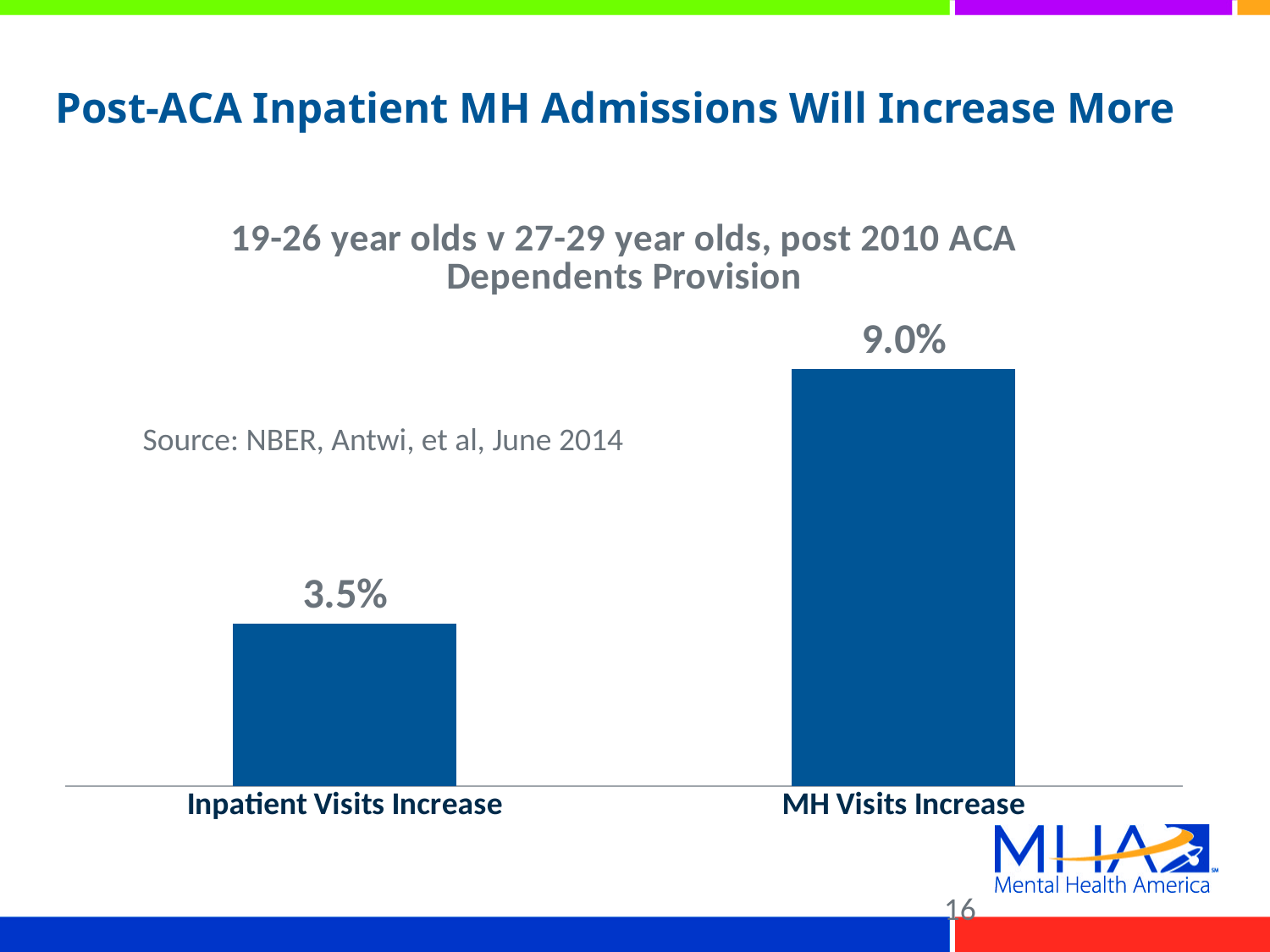
What source is cited for the chart data? NBER, Antwi, et al, June 2014 What is the value for Inpatient Visits Increase? 3.5% What is the difference between the MH Visits Increase and the Inpatient Visits Increase values? 5.5% What kind of chart is shown on the slide? Bar chart Which is larger, Inpatient Visits Increase or MH Visits Increase? MH Visits Increase How many categories are shown in the chart? 2 What is the title of the chart? 19-26 year olds v 27-29 year olds, post 2010 ACA Dependents Provision What is the value for MH Visits Increase? 9.0% Which category has the highest value? MH Visits Increase Which category has the lowest value? Inpatient Visits Increase